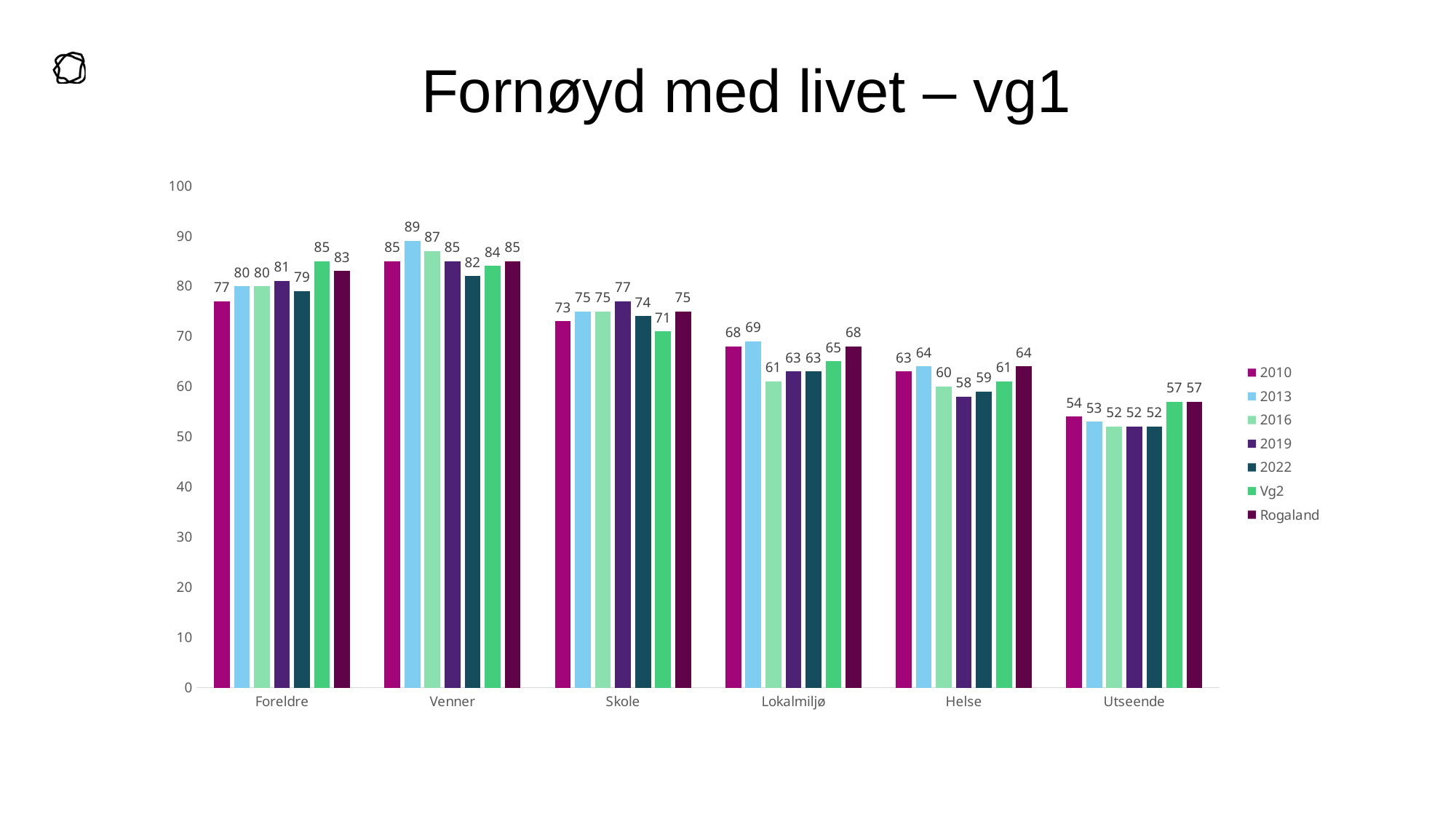
Which category has the highest value for the 2013 series? Venner In the Helse category, which is larger: the 2010 value or the 2019 value? 2010 What is the value for 2022 in the Venner category? 82 What is the value for 2016 in the Lokalmiljø category? 61 Which category has the lowest value for the 2010 series? Utseende What is the title of the chart? Fornøyd med livet – vg1 What is the value for Vg2 in the Foreldre category? 85 What kind of chart is shown on the slide? Bar chart How many series does the legend list? 7 What is the difference between the 2013 and 2022 values in the Venner category? 7 Is the value for Rogaland in the Skole category greater or less than 70? greater How many categories are shown on the x axis? 6